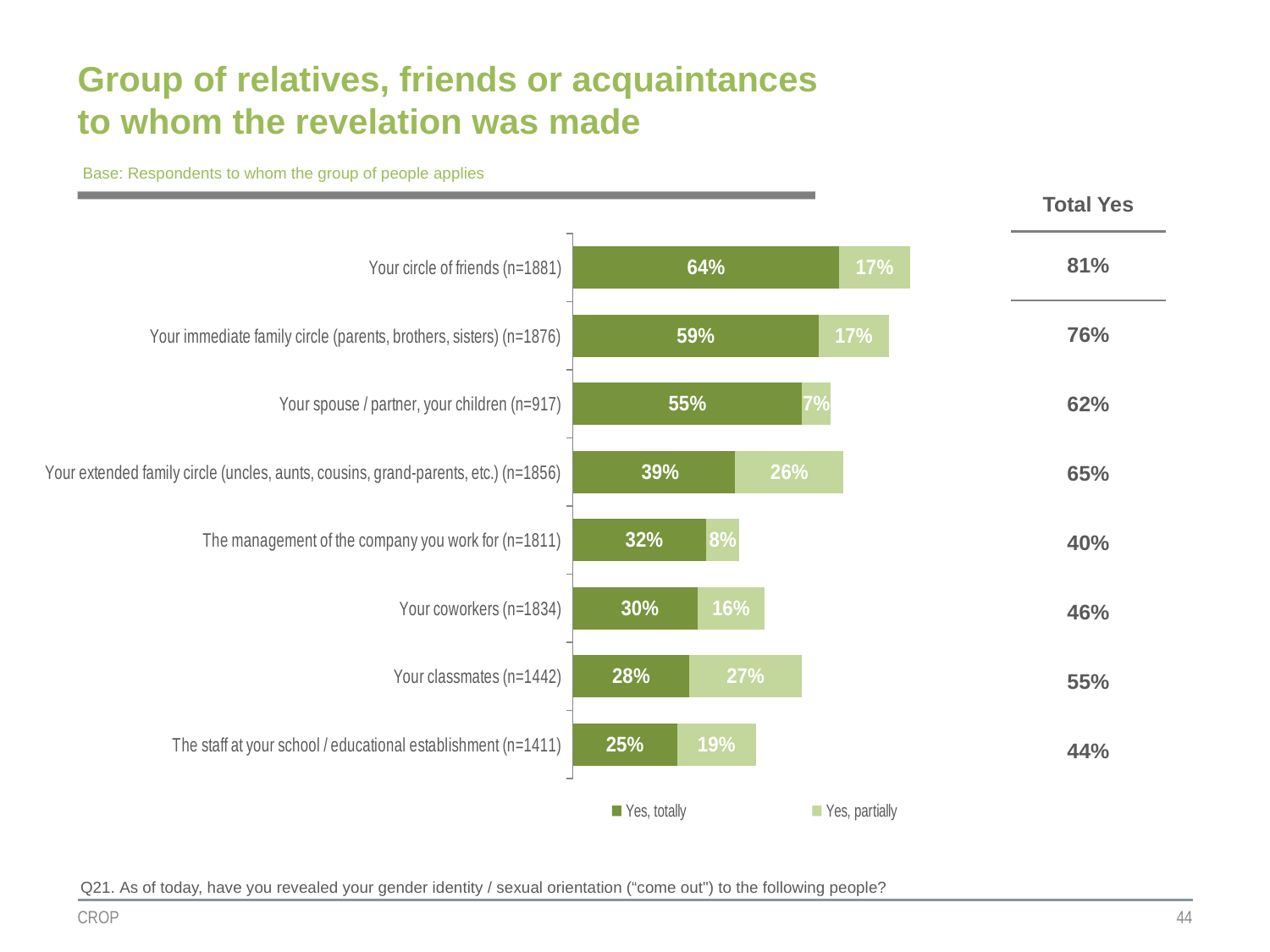
How many categories are shown in the chart? 8 How many series does the legend list? 2 What kind of chart is shown on the slide? Bar chart What is the 'Yes, partially' value for 'Your spouse / partner, your children (n=917)'? 7% What are the two legend entries of the chart? Yes, totally; Yes, partially What is the 'Yes, totally' value for 'Your circle of friends (n=1881)'? 64% Which category has the highest 'Yes, totally' value? Your circle of friends (n=1881) What is the total of the stacked bar for 'Your coworkers (n=1834)'? 46% What is the difference between the 'Yes, totally' values for 'Your circle of friends (n=1881)' and 'Your immediate family circle (parents, brothers, sisters) (n=1876)'? 5% Which is larger: the 'Yes, partially' value for 'Your classmates (n=1442)' or for 'Your coworkers (n=1834)'? Your classmates (n=1442) What is the 'Yes, partially' value for 'Your extended family circle (uncles, aunts, cousins, grand-parents, etc.) (n=1856)'? 26% Which category has the lowest 'Yes, totally' value? The staff at your school / educational establishment (n=1411)